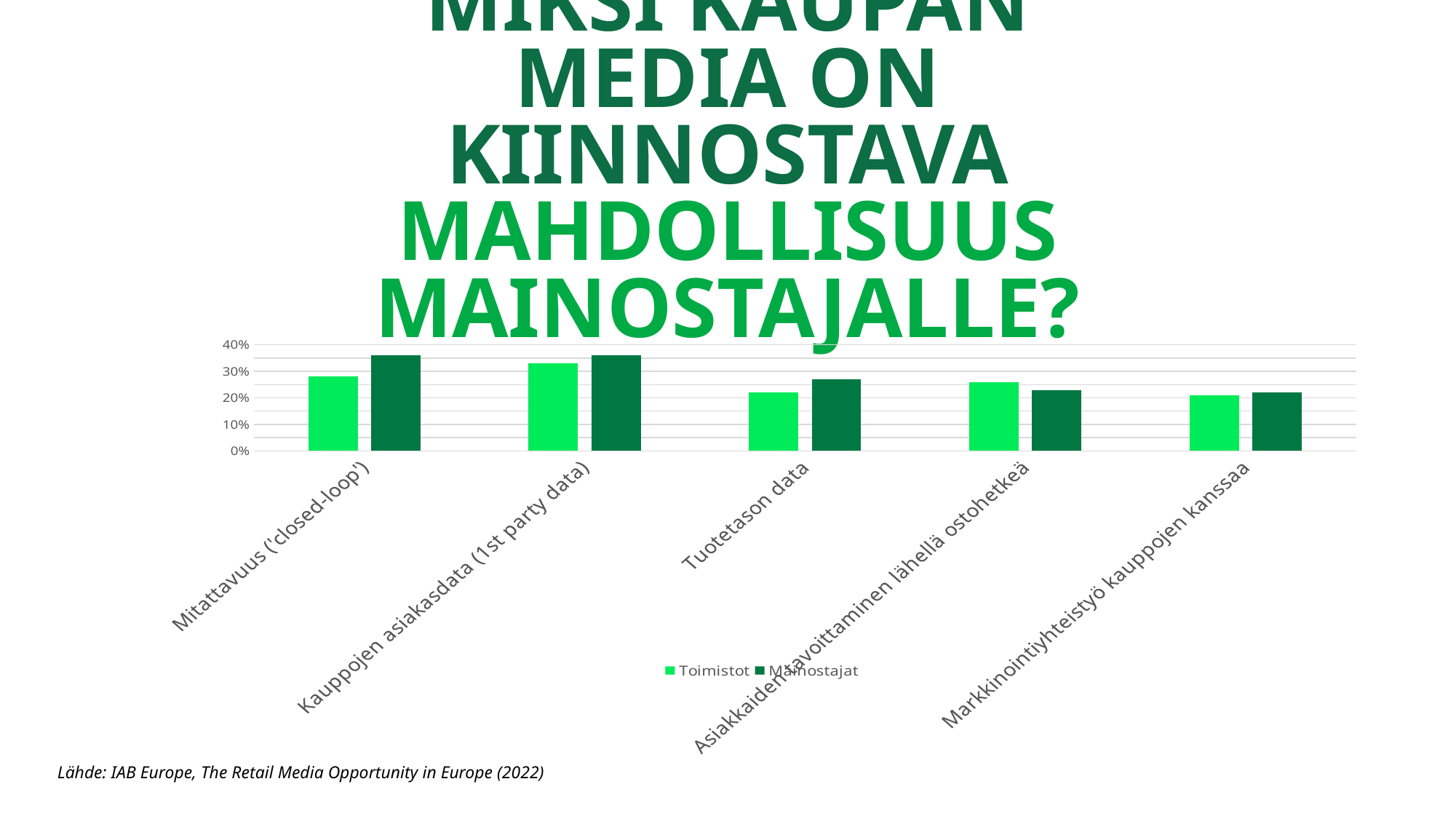
For Asiakkaiden tavoittaminen lähellä ostohetkeä, which series has the larger value, Toimistot or Mainostajat? Toimistot Is the Mainostajat value for Mitattavuus ('closed-loop') greater or less than 30%? greater How many categories are shown on the x axis of the chart? 5 Is the Mainostajat value for Markkinointiyhteistyö kauppojen kanssaa greater or less than 30%? less What kind of chart is shown on the slide? bar chart How many series does the chart's legend list? 2 What are the two series named in the chart's legend? Toimistot and Mainostajat For Tuotetason data, which series has the larger value, Toimistot or Mainostajat? Mainostajat For Mitattavuus ('closed-loop'), which series has the larger value, Toimistot or Mainostajat? Mainostajat Which category has the highest value for the Toimistot series? Kauppojen asiakasdata (1st party data) Is the Toimistot value for Kauppojen asiakasdata (1st party data) greater or less than 30%? greater